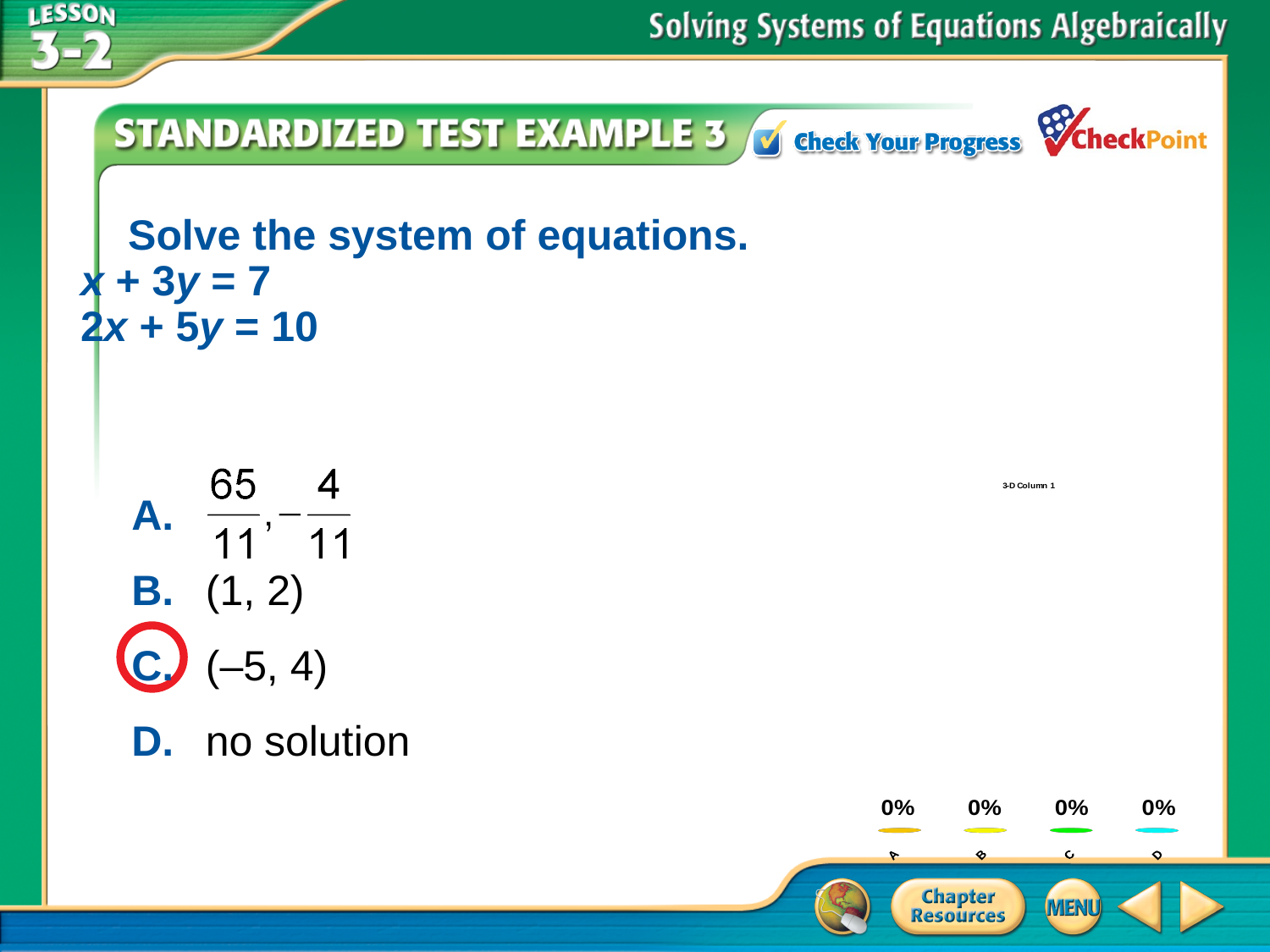
What value is shown for category B in the chart at the bottom right of the slide? 0% What value is shown for category C in the chart at the bottom right of the slide? 0% What value is shown for category D in the chart at the bottom right of the slide? 0% What kind of chart is shown at the bottom right of the slide? bar chart What are the category labels along the x axis of the chart at the bottom right of the slide? A, B, C, D How many categories are plotted in the chart at the bottom right of the slide? 4 What is the difference between the values for category A and category D in the chart at the bottom right of the slide? 0% What value is shown for category A in the chart at the bottom right of the slide? 0%